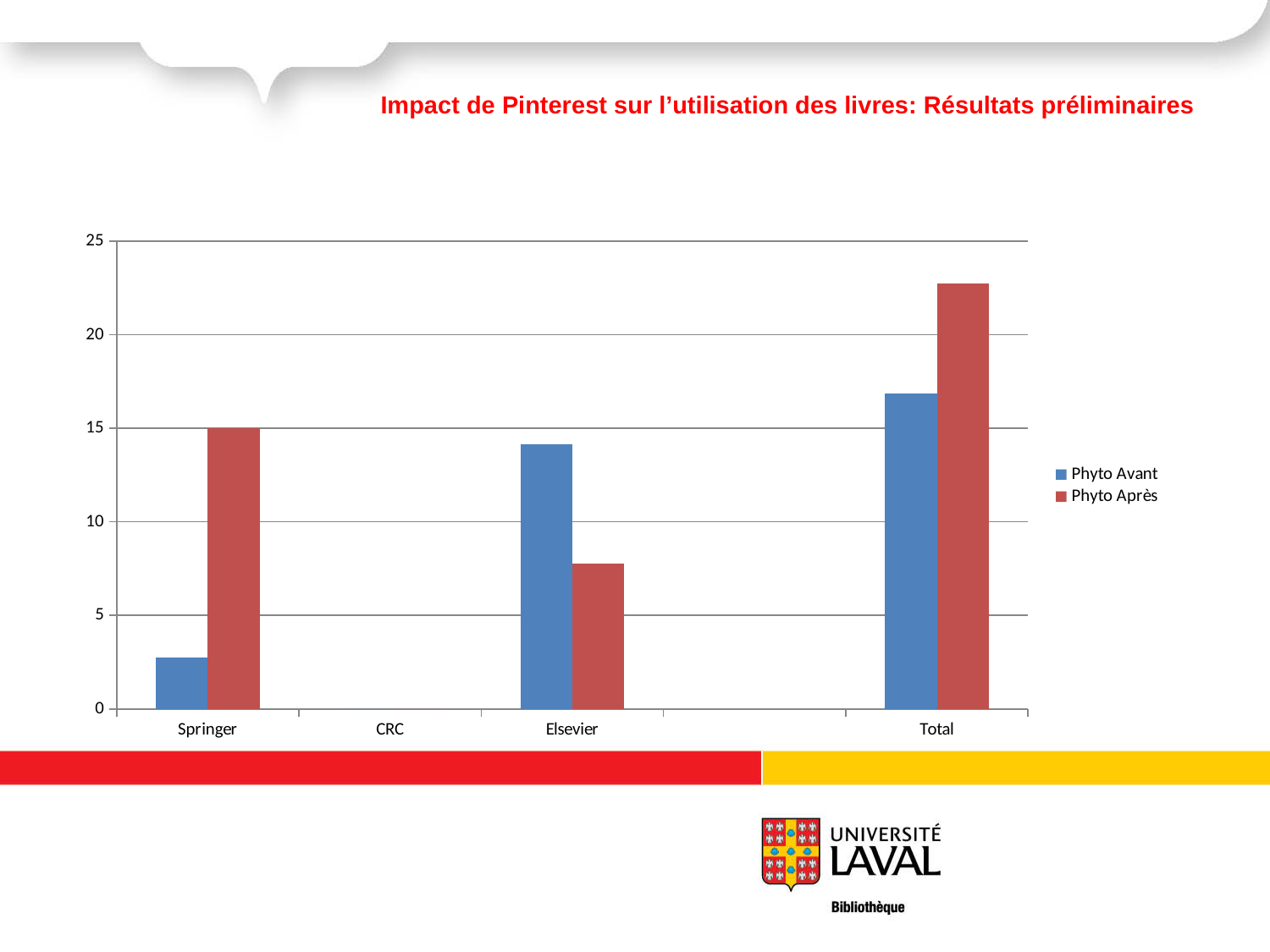
Which category has the highest Phyto Avant value? Total For Springer, which is larger: Phyto Avant or Phyto Après? Phyto Après Is the Phyto Après value for Total greater or less than 20? greater What is the title of the slide containing the chart? Impact de Pinterest sur l’utilisation des livres: Résultats préliminaires Which category on the x axis shows no bars at all? CRC For Elsevier, which is larger: Phyto Avant or Phyto Après? Phyto Avant How many series does the legend list? 2 Is the Phyto Avant value for Total greater or less than 15? greater Which category has the highest Phyto Après value? Total Is the Phyto Avant value for Springer greater or less than 5? less What kind of chart is shown on the slide? bar chart